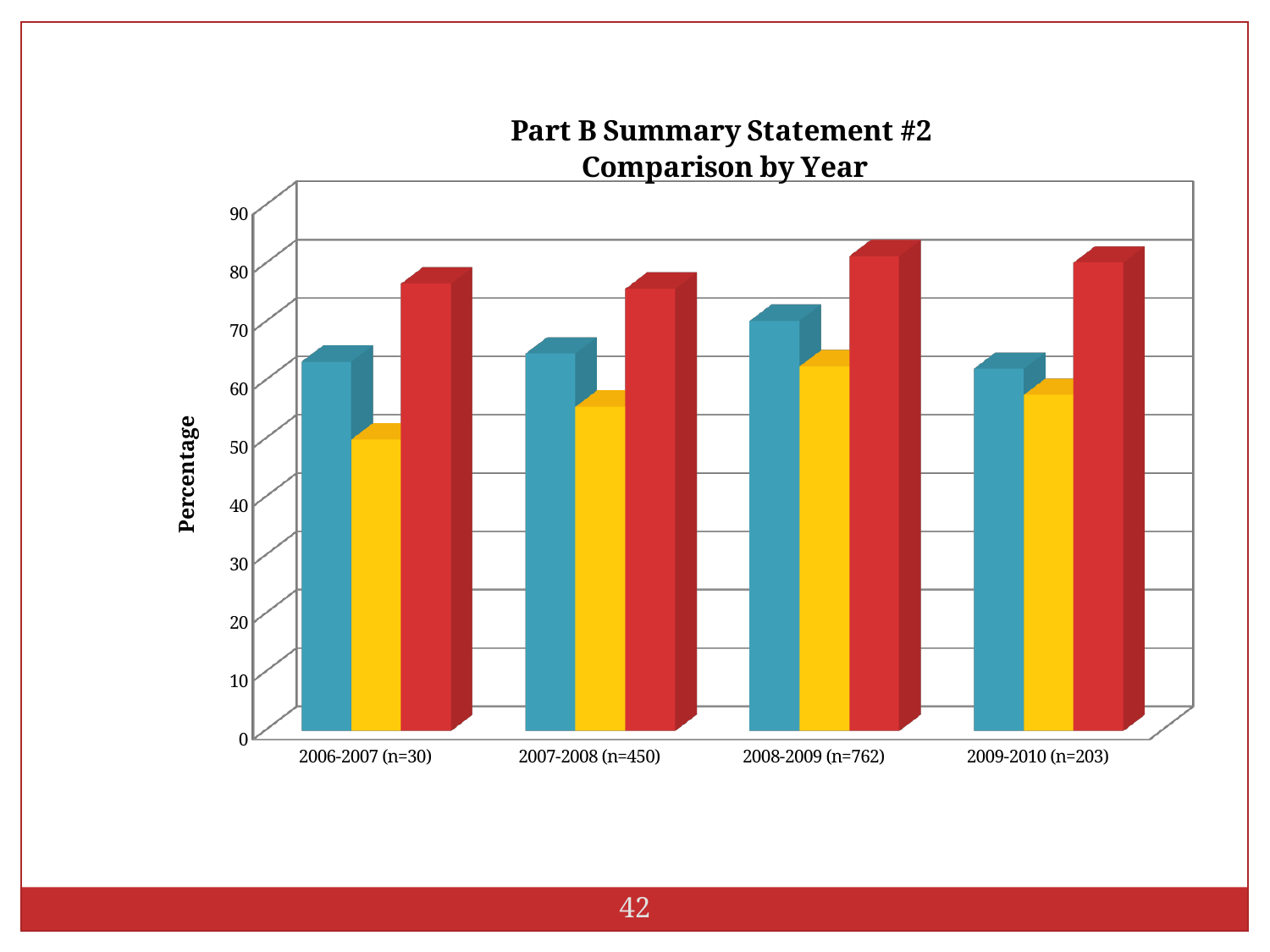
How many year categories are shown on the x axis? 4 Among the blue bars, which year has the highest value? 2008-2009 (n=762) Is the value of the blue bar for 2008-2009 (n=762) greater or less than 60? greater What is the label on the vertical axis? Percentage What is the title of the chart? Part B Summary Statement #2 Comparison by Year Is the value of the red bar for 2008-2009 (n=762) greater or less than 70? greater For 2006-2007 (n=30), which is larger: the red bar or the yellow bar? The red bar Among the yellow bars, which year has the lowest value? 2006-2007 (n=30) Is the value of the yellow bar for 2006-2007 (n=30) greater or less than 60? less How many bars are shown for each year category? 3 What kind of chart is shown on the slide? Bar chart